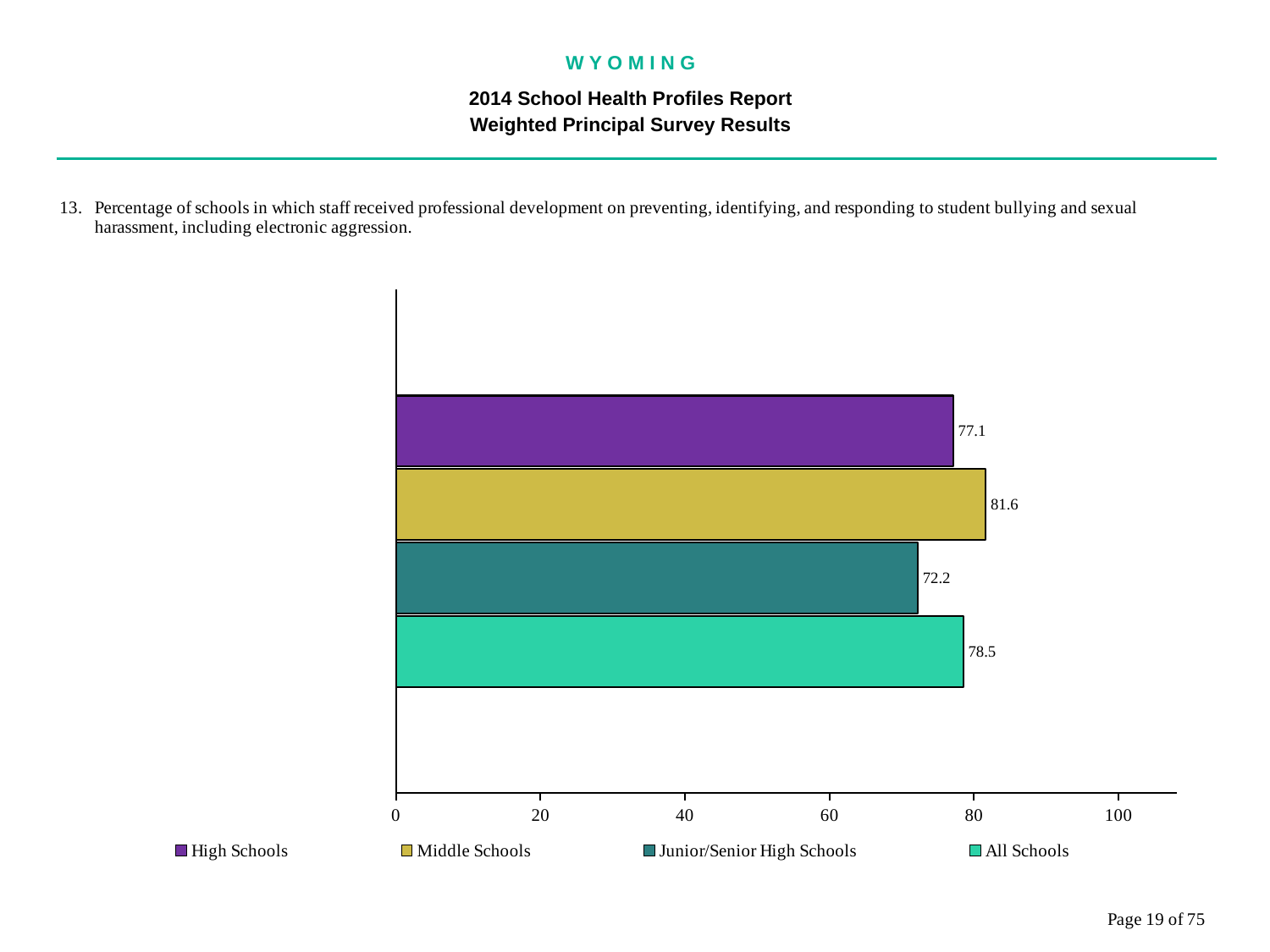
Which is larger, the value for High Schools or the value for All Schools? All Schools What is the value for Middle Schools? 81.6 Which school type has the lowest value? Junior/Senior High Schools What is the value for Junior/Senior High Schools? 72.2 What is the difference between the values for All Schools and High Schools? 1.4 How many bars are shown in the chart? 4 What is the value for High Schools? 77.1 Is the value for Junior/Senior High Schools greater or less than 80? less What is the difference between the values for Middle Schools and Junior/Senior High Schools? 9.4 What is the value for All Schools? 78.5 What kind of chart is shown on the slide? bar chart Which school type has the highest value? Middle Schools